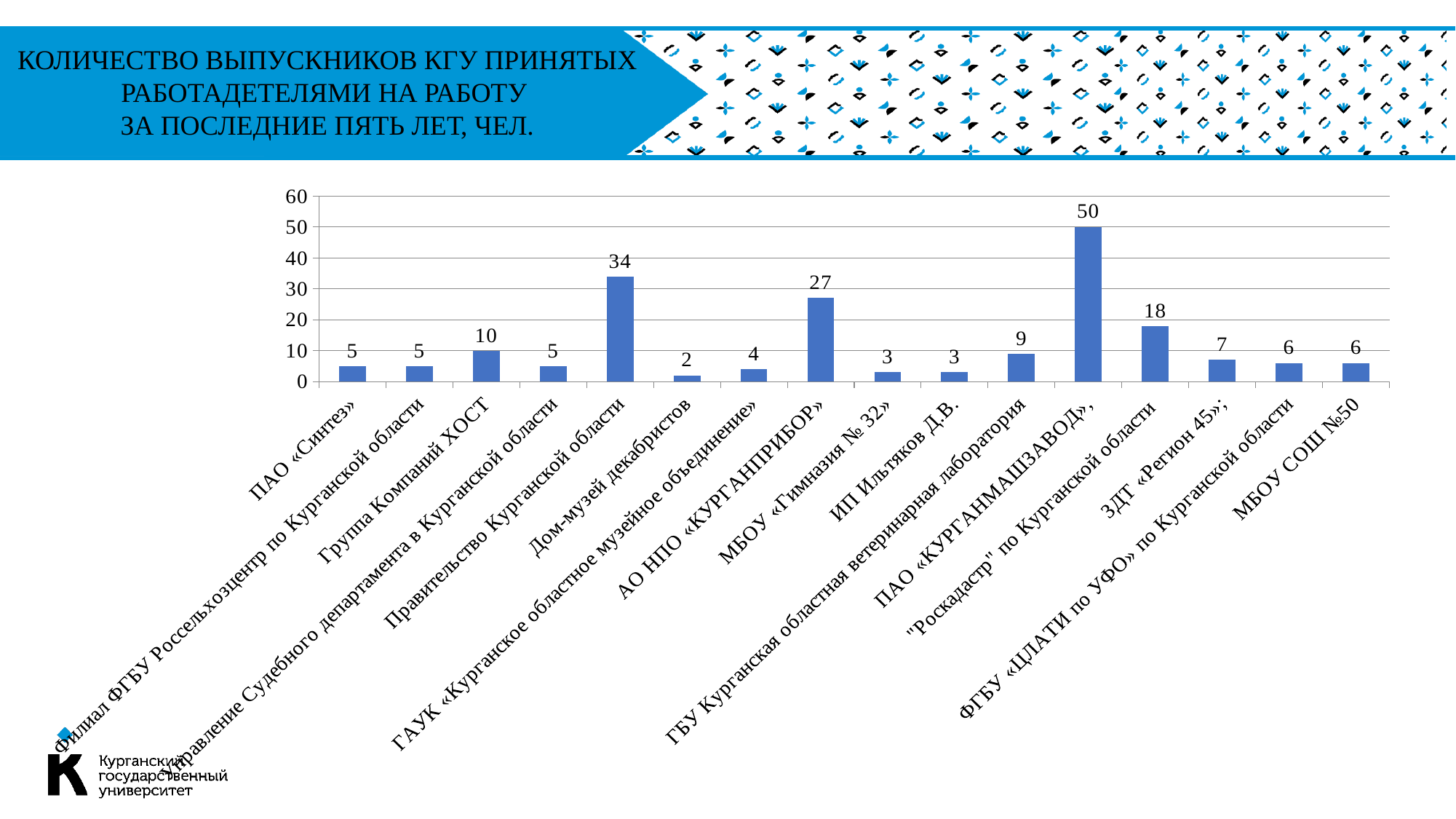
What is the value for ЗДТ «Регион 45»? 7 What is the value for Правительство Курганской области? 34 Which is larger, the value for Группа Компаний ХОСТ or the value for ГБУ Курганская областная ветеринарная лаборатория? Группа Компаний ХОСТ What kind of chart is shown on the slide? bar chart Which employer has the lowest number of hired graduates? Дом-музей декабристов Which employer has the highest number of hired graduates? ПАО «КУРГАНМАШЗАВОД» What is the value for АО НПО «КУРГАНПРИБОР»? 27 How many employers (categories) are shown on the chart? 16 What is the value for "Роскадастр" по Курганской области? 18 What is the difference between the values for ПАО «КУРГАНМАШЗАВОД» and Правительство Курганской области? 16 Is the value for АО НПО «КУРГАНПРИБОР» greater or less than 20? greater How many graduates were hired by ПАО «КУРГАНМАШЗАВОД»? 50